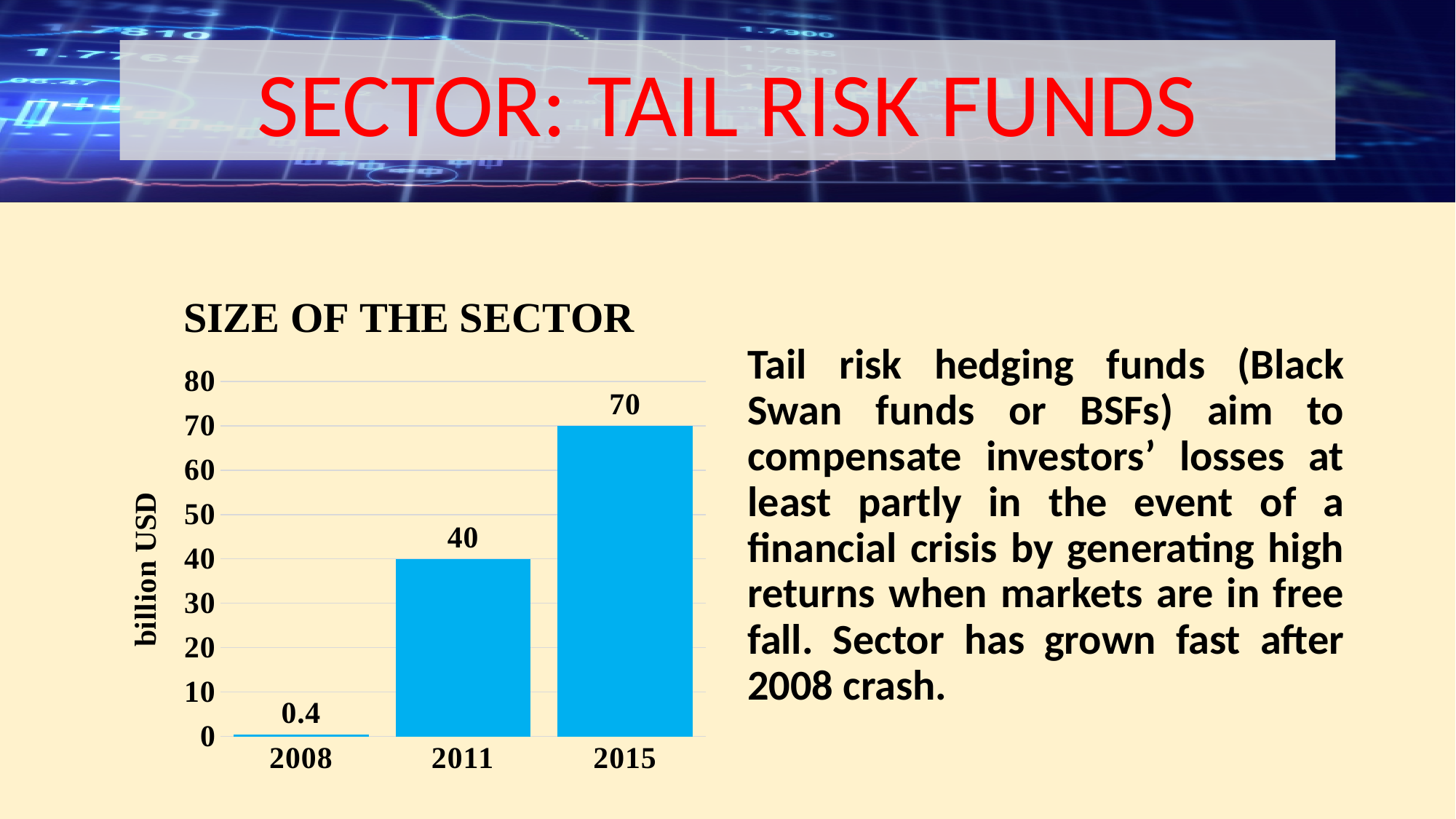
What is the value for 2011 in the chart? 40 What kind of chart is shown on the slide? bar chart What is the value for 2008 in the chart? 0.4 Which is larger, the value for 2011 or the value for 2015? 2015 Do the values rise or fall from 2008 to 2015? rise What is the difference between the values for 2011 and 2008? 39.6 Which year has the highest value in the chart? 2015 Which year has the lowest value in the chart? 2008 How many years are shown on the x axis of the chart? 3 Is the value for 2015 greater or less than 60? greater What is the value for 2015 in the chart? 70 What is the difference between the values for 2015 and 2011? 30